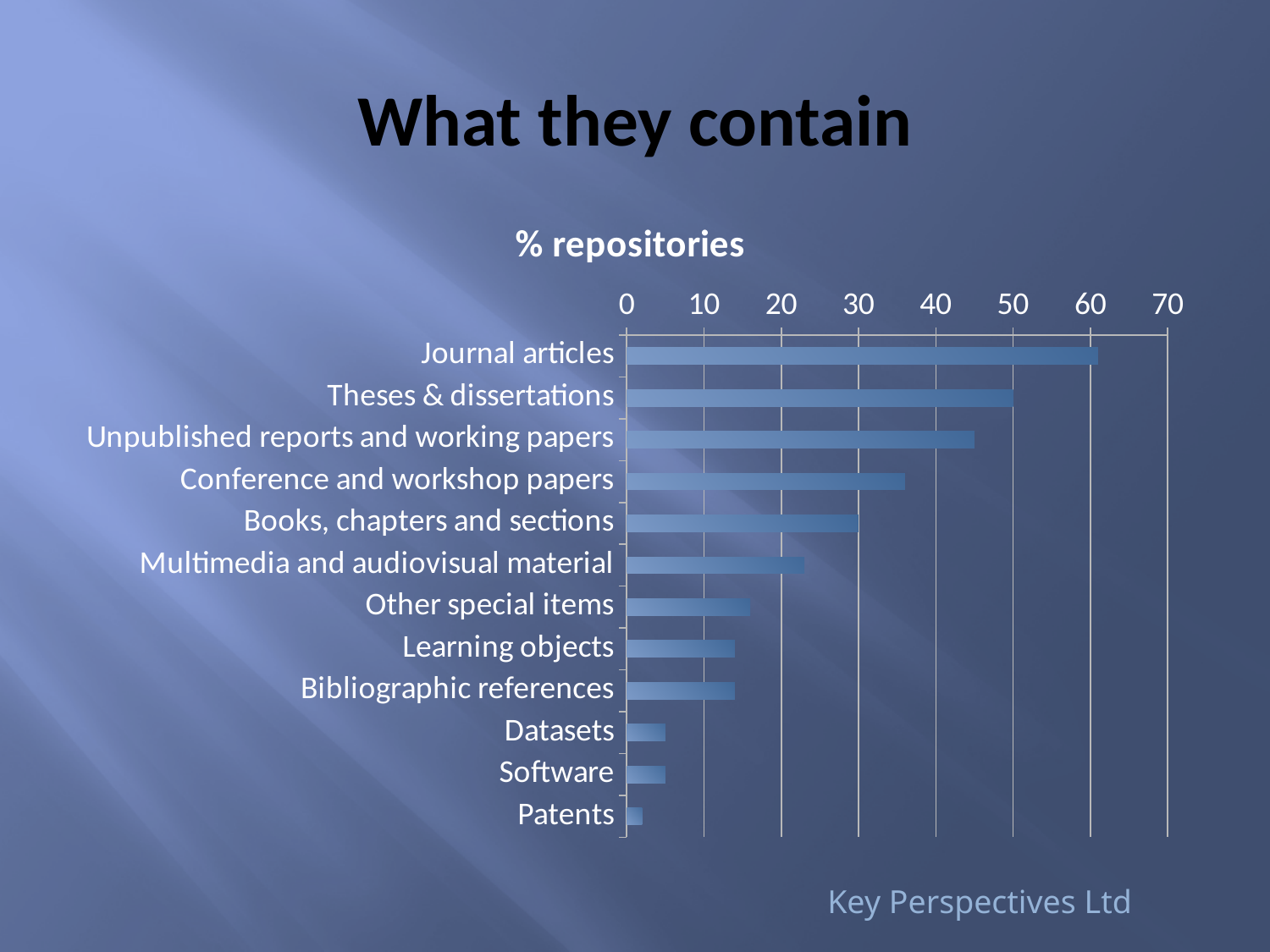
Is the value for Datasets greater or less than 10? less What kind of chart is shown on the slide? bar chart Which is larger, the value for Theses & dissertations or the value for Books, chapters and sections? Theses & dissertations Which is larger, the value for Other special items or the value for Software? Other special items How many categories are plotted in the chart? 12 Which category has the highest value? Journal articles What is the title of the chart? % repositories Is the value for Unpublished reports and working papers greater or less than 40? greater Is the value for Journal articles greater or less than 60? greater Which category has the lowest value? Patents